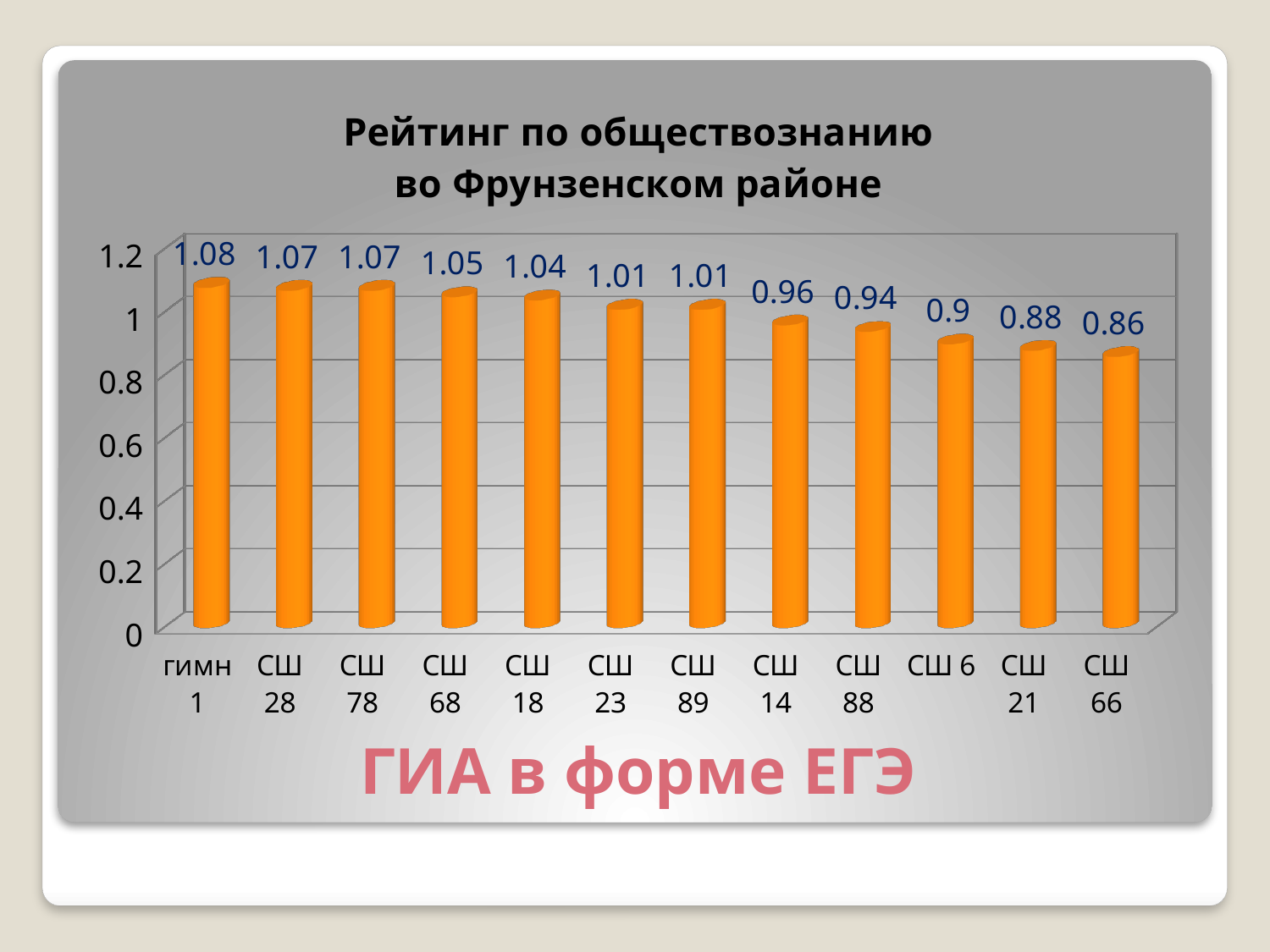
What is the difference between the values for гимн 1 and СШ 66? 0.22 Which is larger, the value for СШ 68 or the value for СШ 88? СШ 68 What is the value for СШ 66? 0.86 What is the value for гимн 1? 1.08 What is the value for СШ 14? 0.96 Do the values rise or fall from left to right along the x axis? fall Which category has the highest value? гимн 1 Is the value for СШ 21 greater or less than 1? less What kind of chart is this? bar chart How many categories are shown on the x axis? 12 What is the value for СШ 6? 0.9 Which category has the lowest value? СШ 66